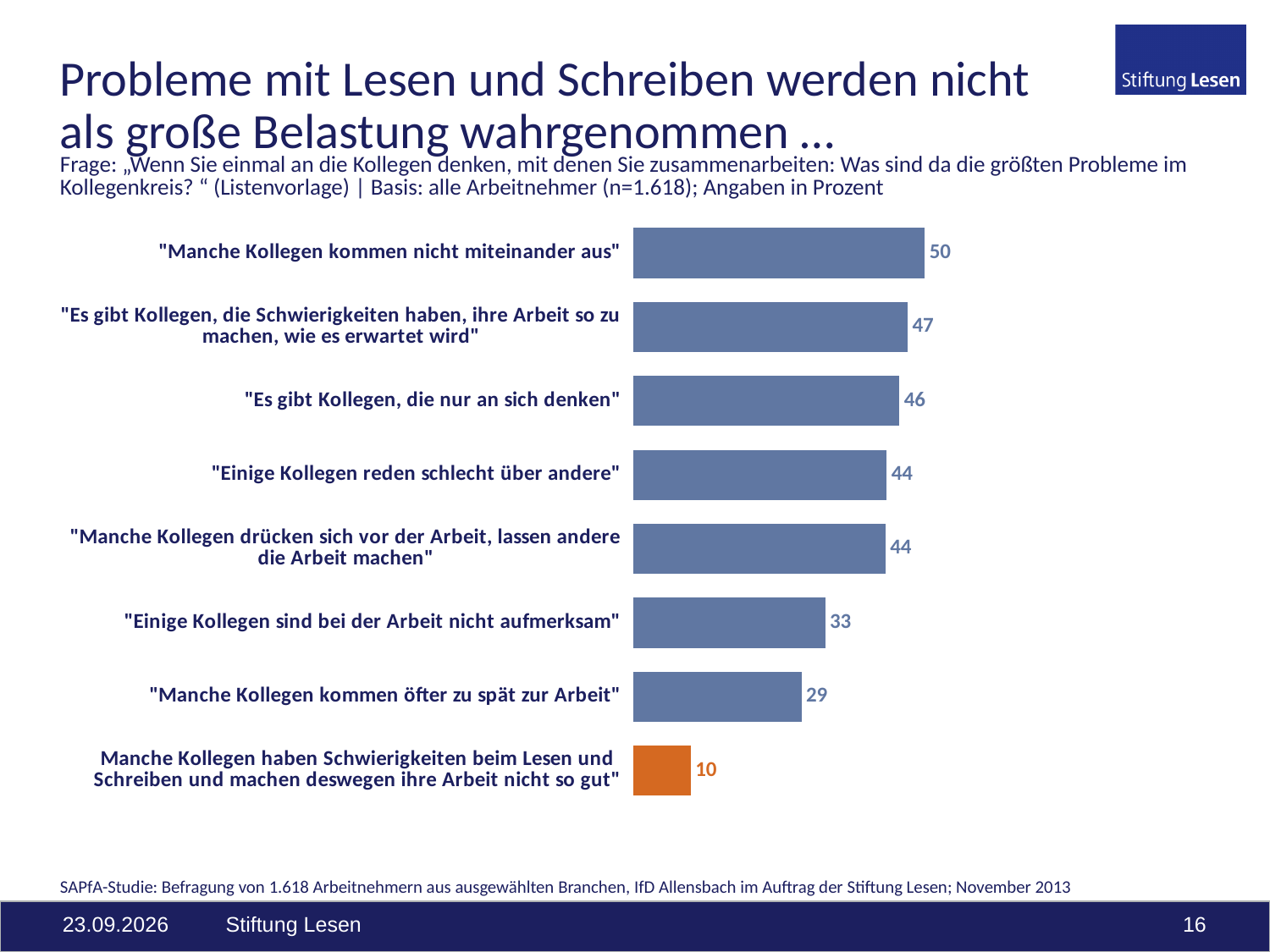
What value is shown for "Einige Kollegen sind bei der Arbeit nicht aufmerksam"? 33 Which category has the highest value? "Manche Kollegen kommen nicht miteinander aus" How many categories are shown in the chart? 8 Which bar is shown in a different colour (orange) from the others? Manche Kollegen haben Schwierigkeiten beim Lesen und Schreiben und machen deswegen ihre Arbeit nicht so gut What value is shown for "Manche Kollegen kommen nicht miteinander aus"? 50 What value is shown for "Manche Kollegen haben Schwierigkeiten beim Lesen und Schreiben und machen deswegen ihre Arbeit nicht so gut"? 10 Which category has the lowest value? Manche Kollegen haben Schwierigkeiten beim Lesen und Schreiben und machen deswegen ihre Arbeit nicht so gut What is the difference between the values for "Es gibt Kollegen, die nur an sich denken" and "Einige Kollegen sind bei der Arbeit nicht aufmerksam"? 13 What value is shown for "Einige Kollegen reden schlecht über andere"? 44 Which is larger: the value for "Einige Kollegen sind bei der Arbeit nicht aufmerksam" or for "Manche Kollegen kommen öfter zu spät zur Arbeit"? "Einige Kollegen sind bei der Arbeit nicht aufmerksam" What is the difference between the values for "Manche Kollegen kommen nicht miteinander aus" and "Manche Kollegen kommen öfter zu spät zur Arbeit"? 21 What kind of chart is shown on the slide? Bar chart